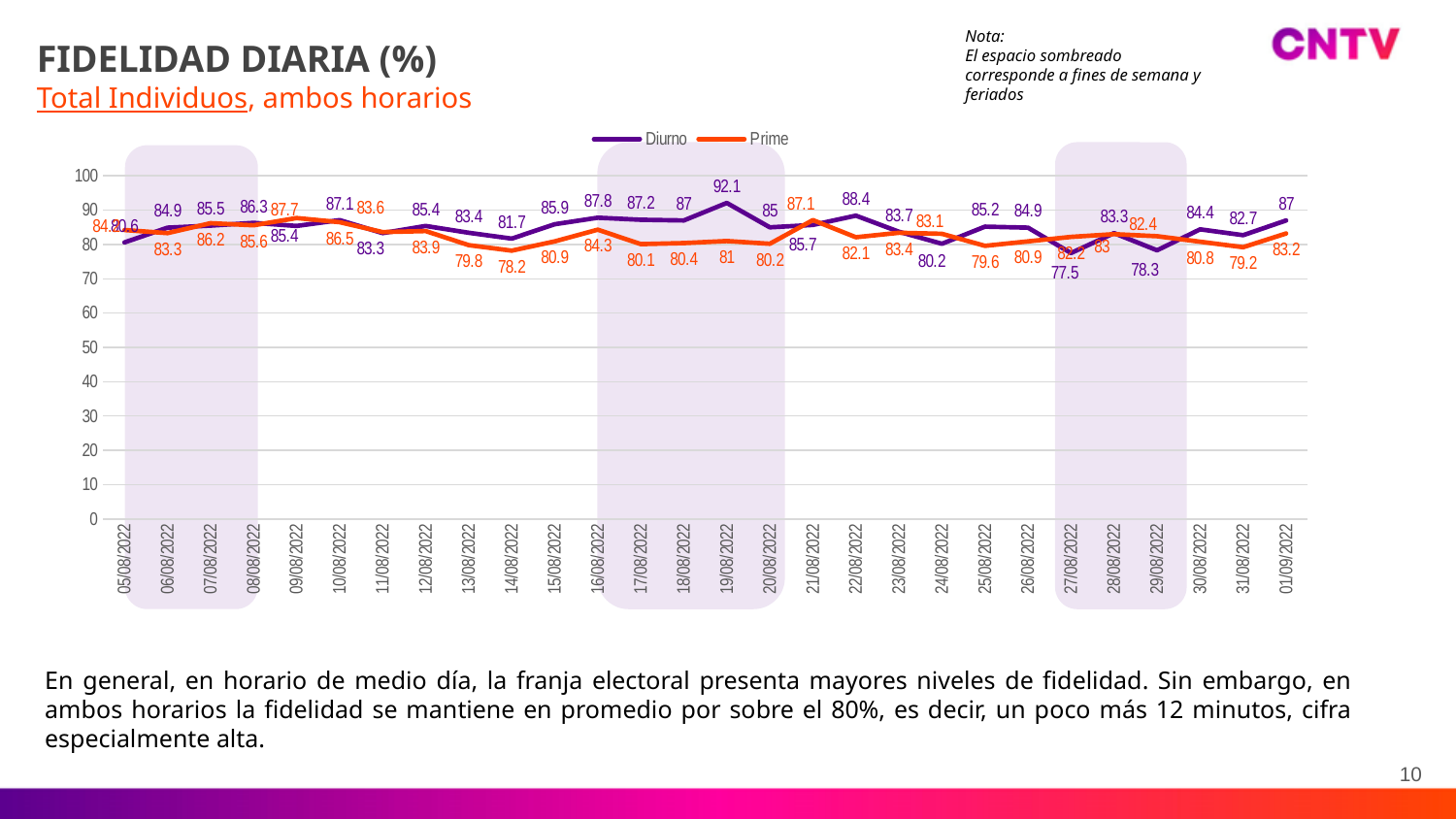
How many series does the legend list? 2 What is the difference between the Diurno and Prime values on 19/08/2022? 11.1 On 19/08/2022, which series has the higher value, Diurno or Prime? Diurno What are the two series named in the legend? Diurno and Prime How many dates are plotted along the x axis? 28 What is the Diurno value on 19/08/2022? 92.1 On which date does the Diurno series reach its highest value? 19/08/2022 What is the Prime value on 14/08/2022? 78.2 What is the Diurno value on 22/08/2022? 88.4 What kind of chart is shown on the slide? line chart On which date does the Diurno series reach its lowest value? 27/08/2022 Is the Diurno value on 19/08/2022 greater or less than 90? greater